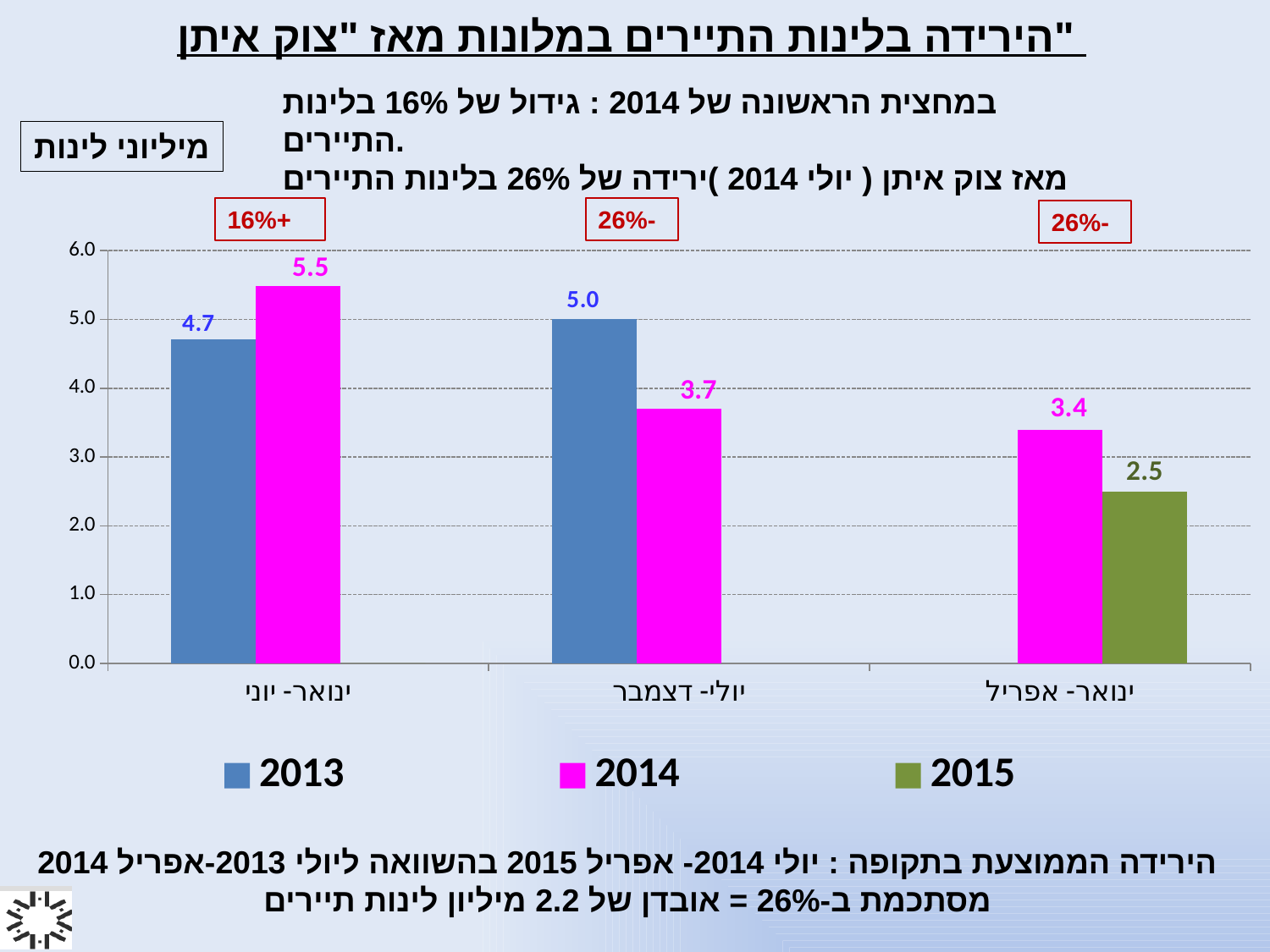
Which bar has the lowest value on the chart? 2015, ינואר-אפריל (2.5) How many categories are shown on the x axis? 3 In the ינואר-אפריל (January–April) category, which is larger: the 2014 value or the 2015 value? 2014 What is the value for 2013 in the יולי-דצמבר (July–December) category? 5.0 Which bar has the highest value on the chart? 2014, ינואר-יוני (5.5) What is the difference between the 2013 and 2014 values in the יולי-דצמבר (July–December) category? 1.3 What unit label is shown in the box at the top left of the chart? מיליוני לינות What is the value for 2014 in the ינואר-יוני (January–June) category? 5.5 How many series does the legend list? 3 What is the value for 2013 in the ינואר-יוני (January–June) category? 4.7 What kind of chart is shown on the slide? Bar chart What is the value for 2015 in the ינואר-אפריל (January–April) category? 2.5